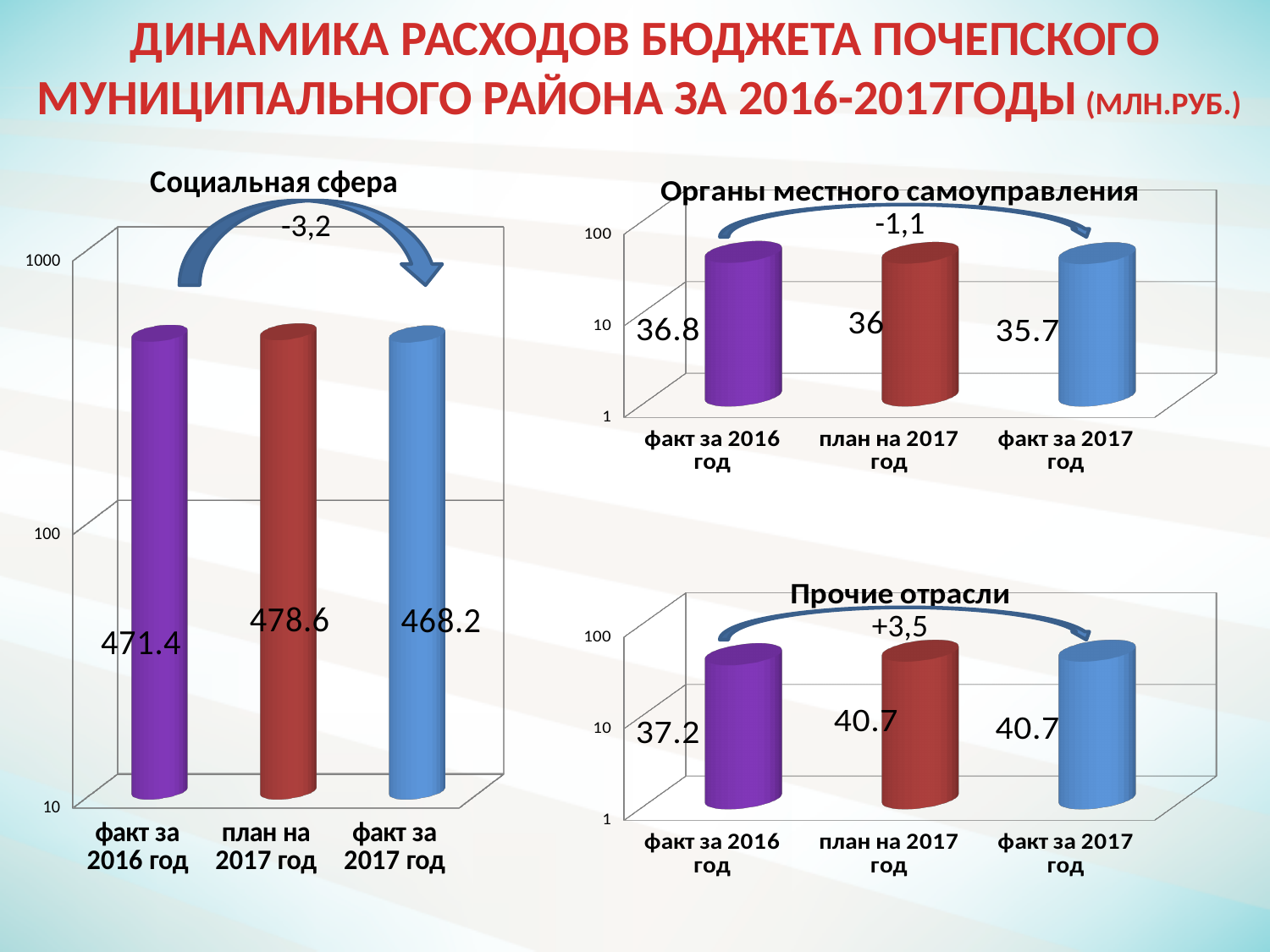
In the 'Социальная сфера' chart, what is the value for 'факт за 2016 год'? 471.4 What kind of chart is the 'Социальная сфера' chart? bar chart In the 'Социальная сфера' chart, what is the difference between 'план на 2017 год' and 'факт за 2017 год'? 10.4 In the 'Социальная сфера' chart, what is the value for 'план на 2017 год'? 478.6 In the 'Органы местного самоуправления' chart, which category has the highest value? факт за 2016 год In the 'Прочие отрасли' chart, what is the value for 'факт за 2016 год'? 37.2 In the 'Социальная сфера' chart, which category has the lowest value? факт за 2017 год In the 'Органы местного самоуправления' chart, what is the value for 'факт за 2017 год'? 35.7 In the 'Прочие отрасли' chart, which is larger: 'факт за 2016 год' or 'факт за 2017 год'? факт за 2017 год How many categories does the 'Прочие отрасли' chart show? 3 In the 'Прочие отрасли' chart, what is the difference between 'план на 2017 год' and 'факт за 2016 год'? 3.5 In the 'Органы местного самоуправления' chart, do the values rise or fall from 'факт за 2016 год' to 'факт за 2017 год'? fall